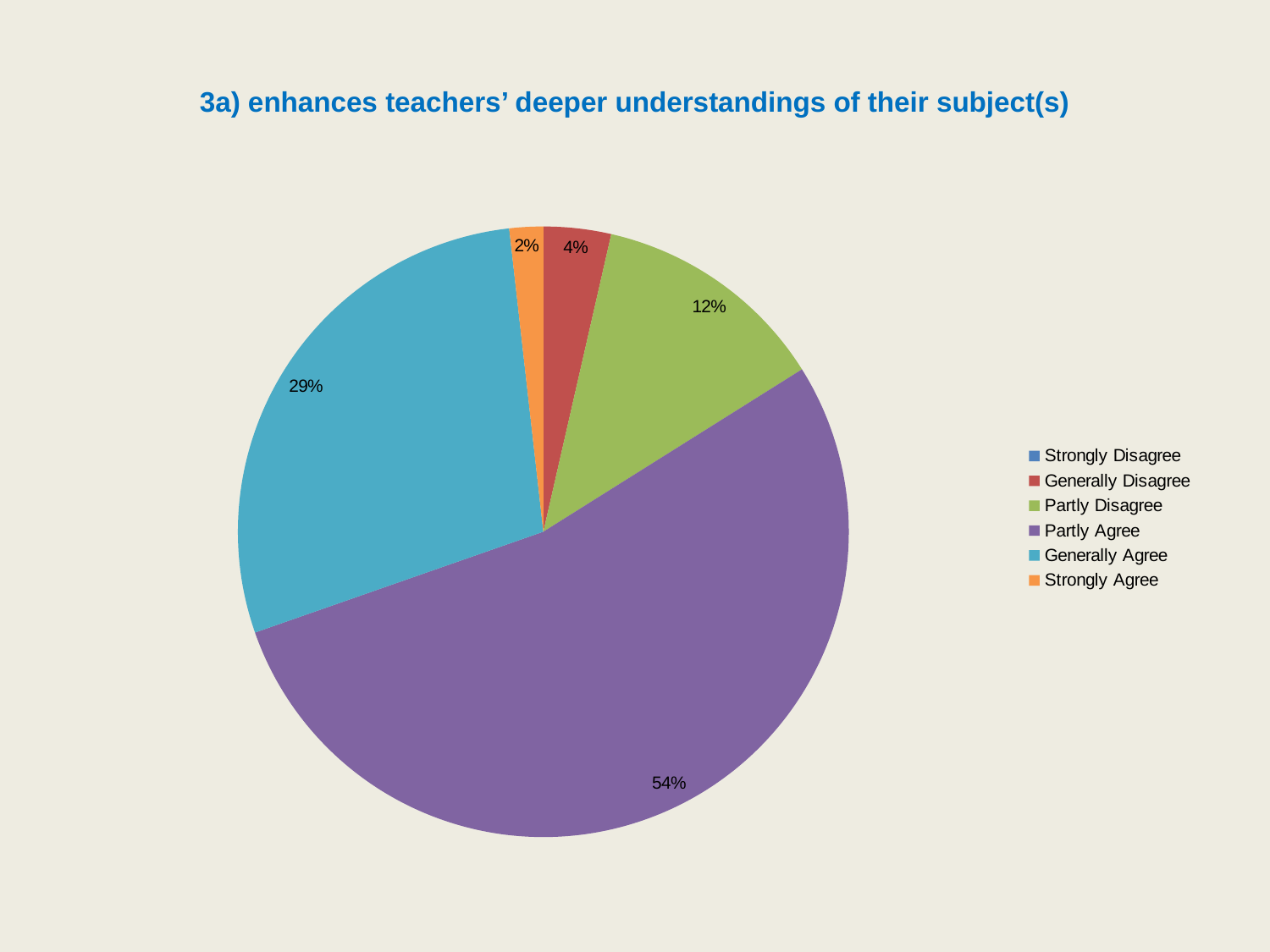
Which is larger, the Partly Disagree slice or the Generally Disagree slice? Partly Disagree What is the difference in percentage points between Partly Agree and Generally Agree? 25 What is the title of the chart? 3a) enhances teachers' deeper understandings of their subject(s) Which category has the largest slice of the pie? Partly Agree What share of the pie does Partly Disagree have? 12% What share of the pie does Partly Agree have? 54% What share of the pie does Strongly Agree have? 2% Which of the labelled slices is the smallest? Strongly Agree How many entries does the legend list? 6 What kind of chart is shown on the slide? pie chart